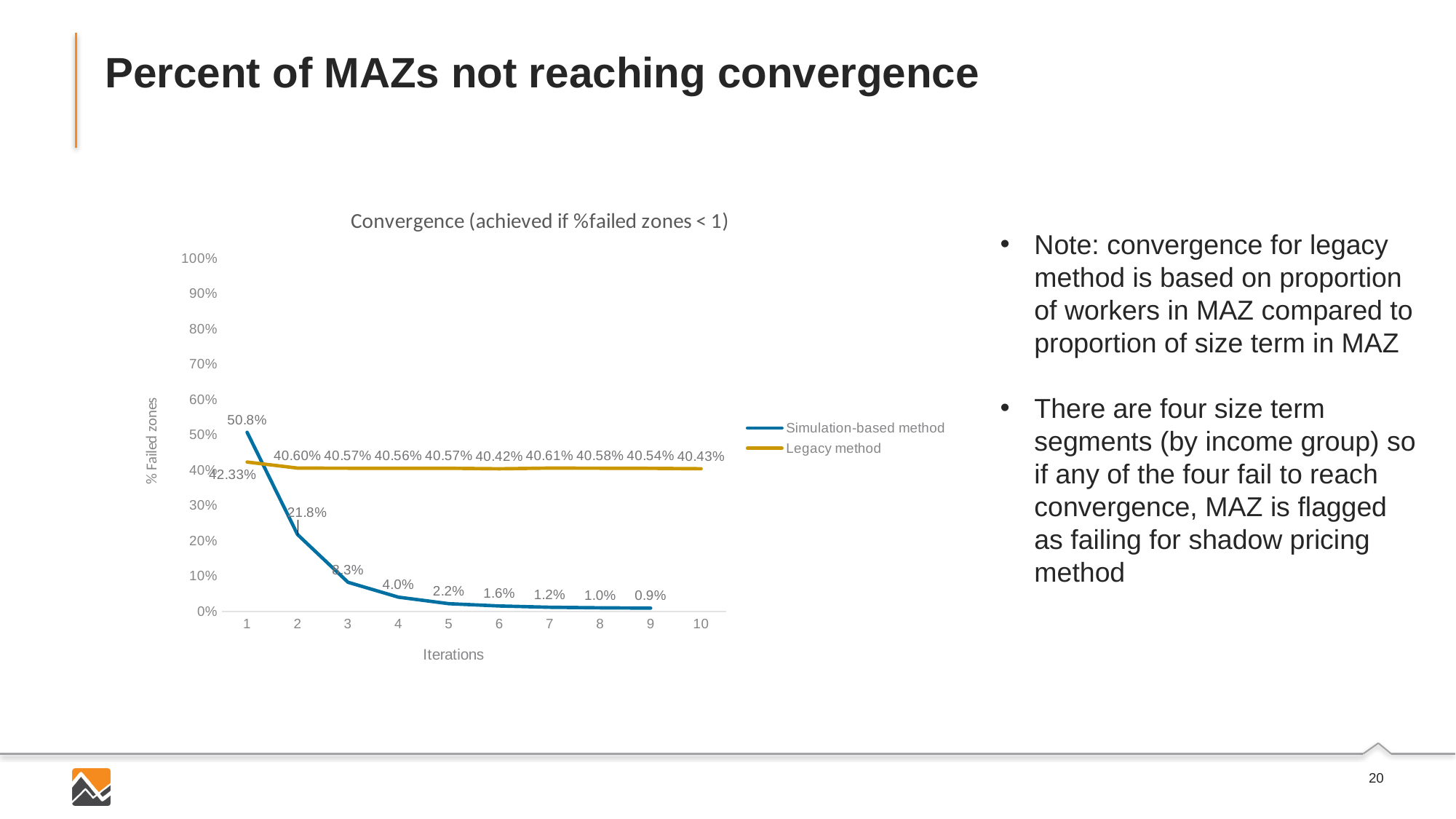
What is the value for the Simulation-based method at iteration 1? 50.8% At which iteration is the Simulation-based method value highest? 1 How many series does the legend list? 2 What is the value for the Legacy method at iteration 1? 42.33% What is the value for the Simulation-based method at iteration 9? 0.9% What is the value for the Simulation-based method at iteration 4? 4.0% What is the difference between the Simulation-based method values at iteration 1 and iteration 2? 29.0 percentage points What kind of chart is shown on the slide? line chart At which iteration is the Simulation-based method value lowest? 9 What is the value for the Legacy method at iteration 10? 40.43% At iteration 5, which series has the higher value, Simulation-based method or Legacy method? Legacy method Does the Simulation-based method line rise or fall as iterations increase? fall